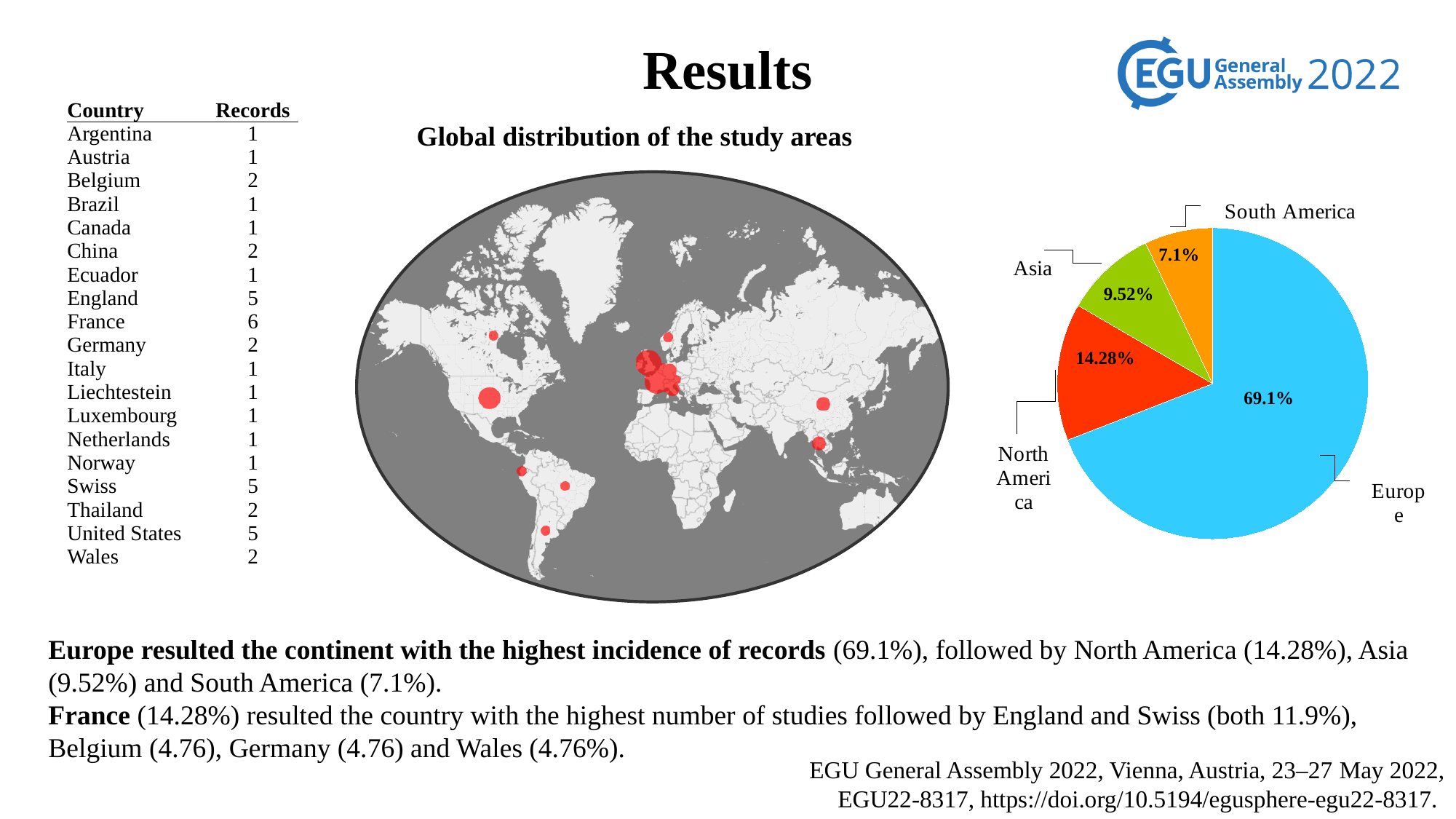
In the pie chart, what share does Europe have? 69.1% In the pie chart, which is larger, the slice for Asia or the slice for North America? North America In the pie chart, what is the difference between the Asia share and the South America share? 2.42% In the pie chart, what is the difference between the Europe share and the North America share? 54.82% What kind of chart is shown on the right of the slide? pie chart Which continent has the smallest slice in the pie chart? South America In the pie chart, what share does South America have? 7.1% Which continent has the largest slice in the pie chart? Europe In the pie chart, what share does Asia have? 9.52% In the pie chart, what share does North America have? 14.28% How many slices does the pie chart have? 4 What colour is the Europe slice in the pie chart? light blue